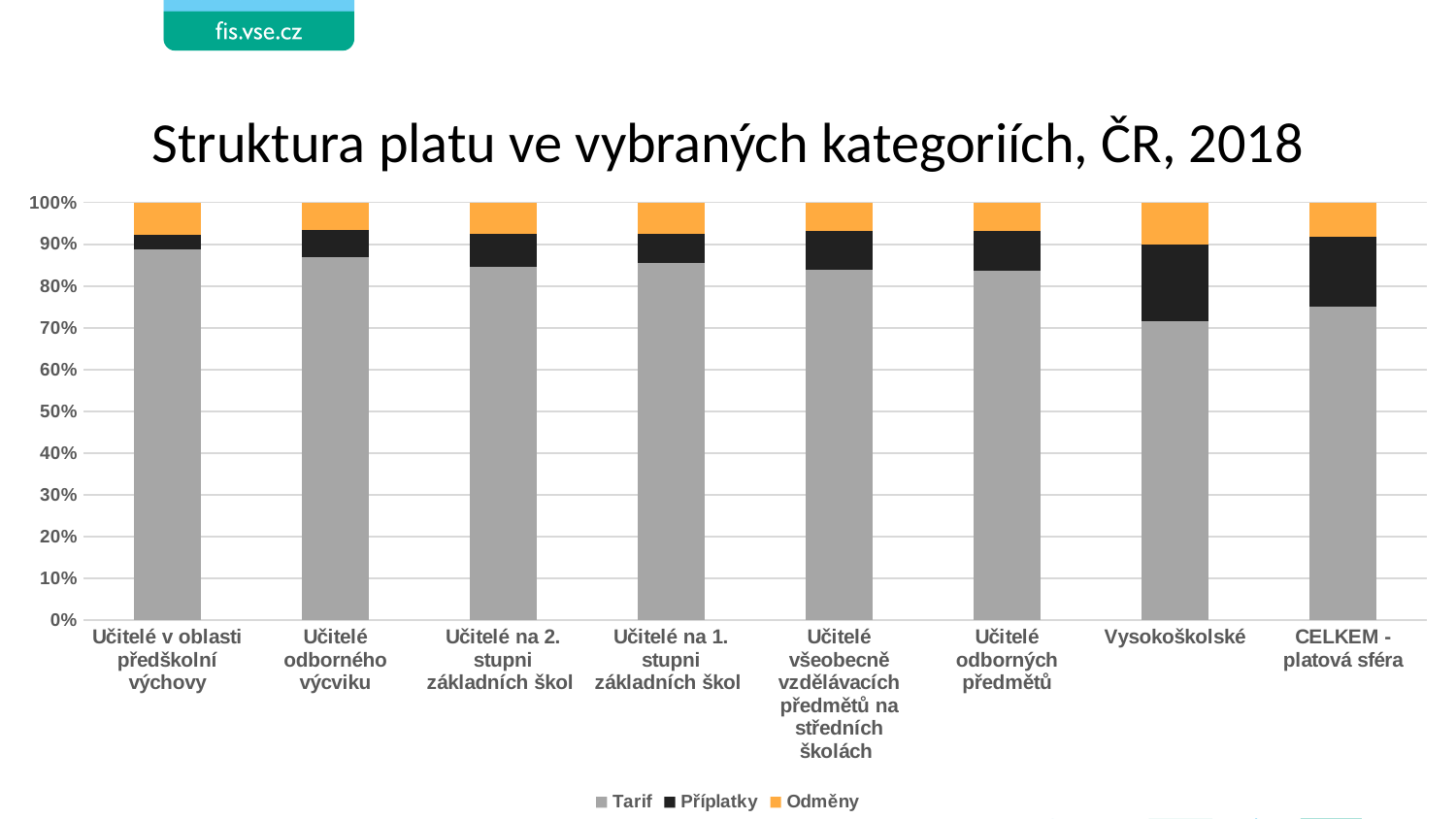
What is the title of the chart? Struktura platu ve vybraných kategoriích, ČR, 2018 How many categories are shown on the x axis of the chart? 8 Is the Tarif value for Vysokoškolské greater or less than 70%? greater Is the Tarif value for CELKEM - platová sféra greater or less than 80%? less Is the Tarif value for Vysokoškolské greater or less than 80%? less How many series does the legend list? 3 What kind of chart is shown on the slide? Stacked bar chart Which category has the largest Příplatky share? Vysokoškolské Which has a larger Tarif share: Vysokoškolské or Učitelé odborných předmětů? Učitelé odborných předmětů Which category has the lowest Tarif share? Vysokoškolské Which colour represents the Odměny series in the chart? Orange